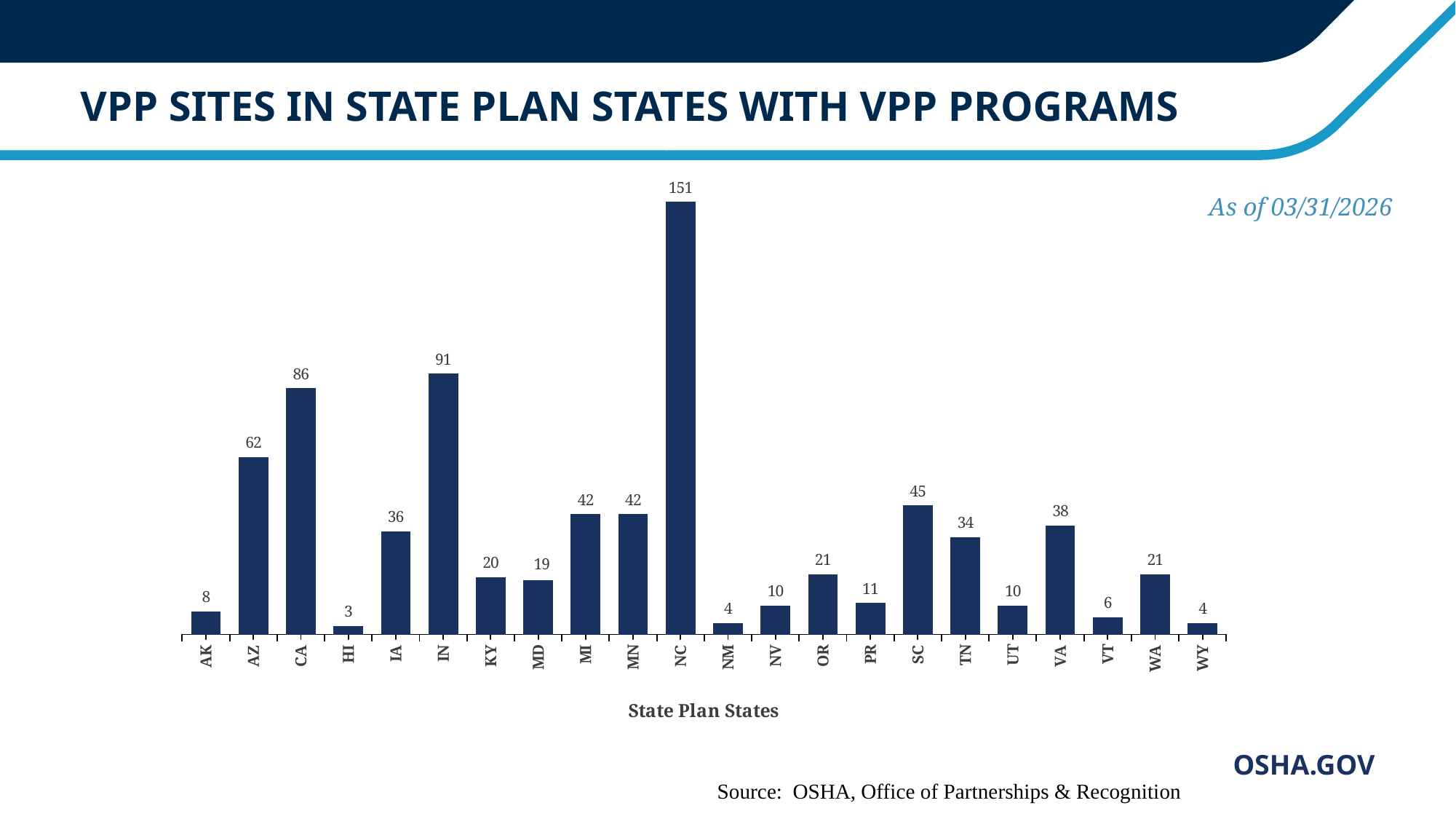
Which state has the lowest number of VPP sites? HI What is the difference between the values for NC and AZ? 89 What is the value shown for VT? 6 How many states are shown on the x axis? 22 Which has more VPP sites, KY or OR? OR What is the x-axis title of the chart? State Plan States What kind of chart is shown on the slide? Bar chart How many VPP sites does NC have? 151 What is the value shown for IA? 36 What is the difference between the values for IN and CA? 5 Which has more VPP sites, SC or TN? SC Which state has the highest number of VPP sites? NC